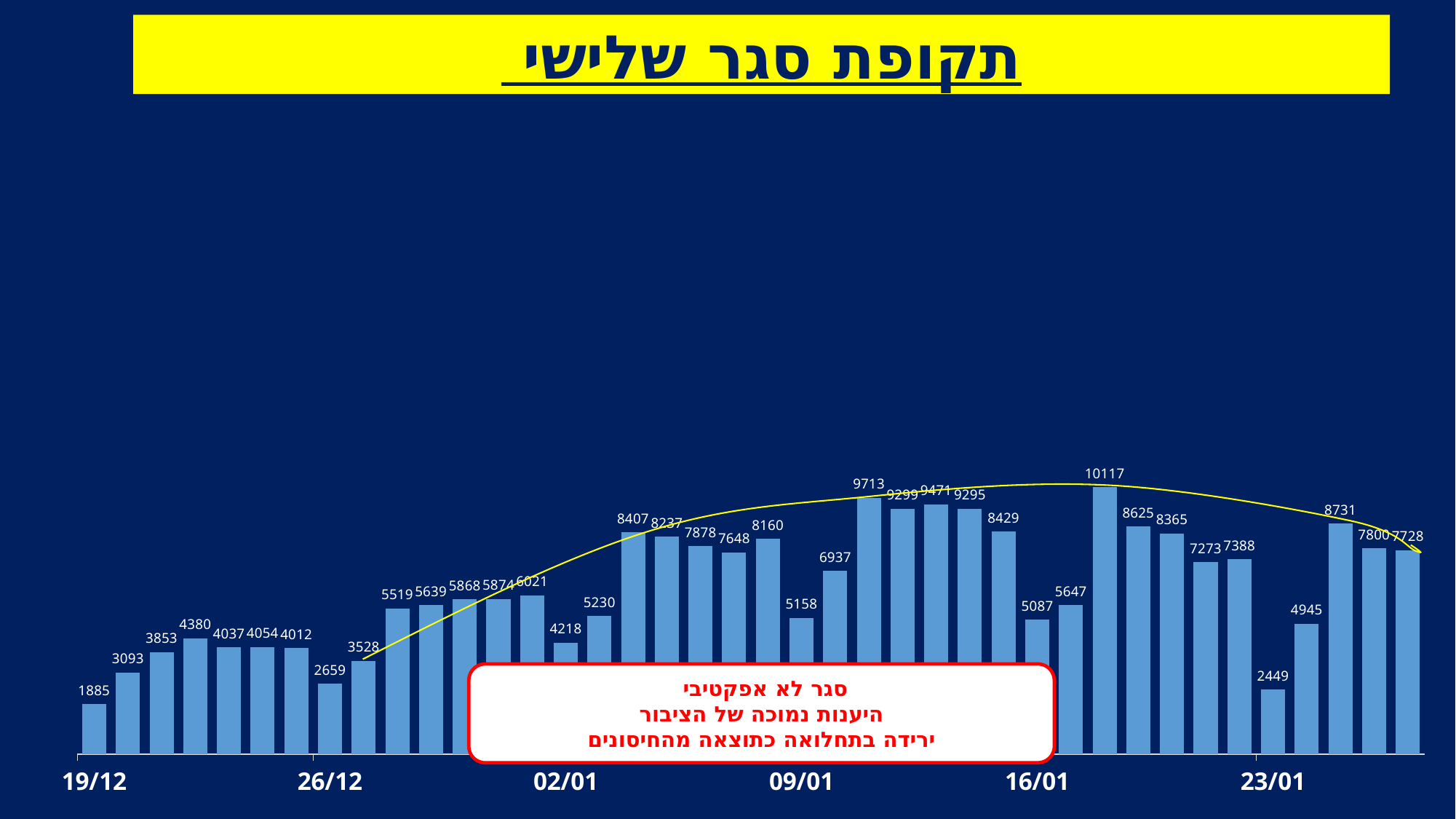
What is the highest value shown on the chart? 10117 What is the value of the bar at 26/12? 2659 What is the difference between the bar at 09/01 (5158) and the bar at 02/01 (4218)? 940 What is the value of the bar at 09/01? 5158 What is the value of the bar at 19/12? 1885 What is the title of the slide? תקופת סגר שלישי What is the value of the bar at 23/01? 2449 What is the value of the bar at 02/01? 4218 What is the lowest value shown on the chart? 1885 Which is larger: the bar at 16/01 or the bar at 23/01? 16/01 How many bars are plotted on the chart? 40 What kind of chart is shown on the slide? bar chart